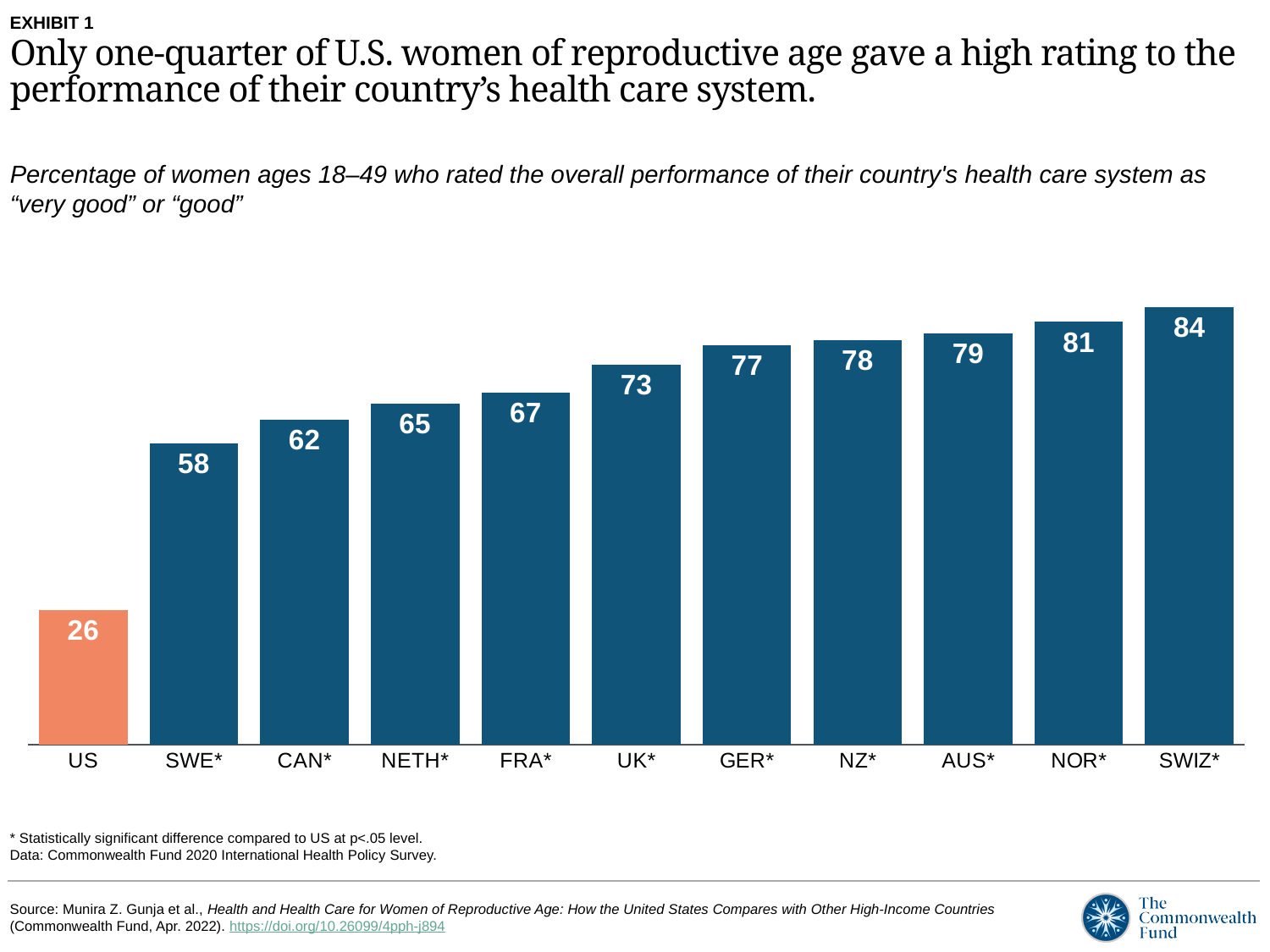
Do the values rise or fall moving from left to right across the chart? Rise Which has a higher value, GER* or NETH*? GER* What percentage of women ages 18–49 in the US rated their health care system's performance as "very good" or "good"? 26 What type of chart is shown on the slide? Bar chart How many countries are shown on the chart? 11 Which bar is shown in a different colour (orange) from the rest? US What is the value shown for NZ*? 78 What is the difference between the values for UK* and CAN*? 11 Which country has the lowest value on the chart? US What is the difference between the values for SWIZ* and US? 58 Which country has the highest percentage of women rating their health care system as "very good" or "good"? SWIZ* What is the value shown for FRA*? 67